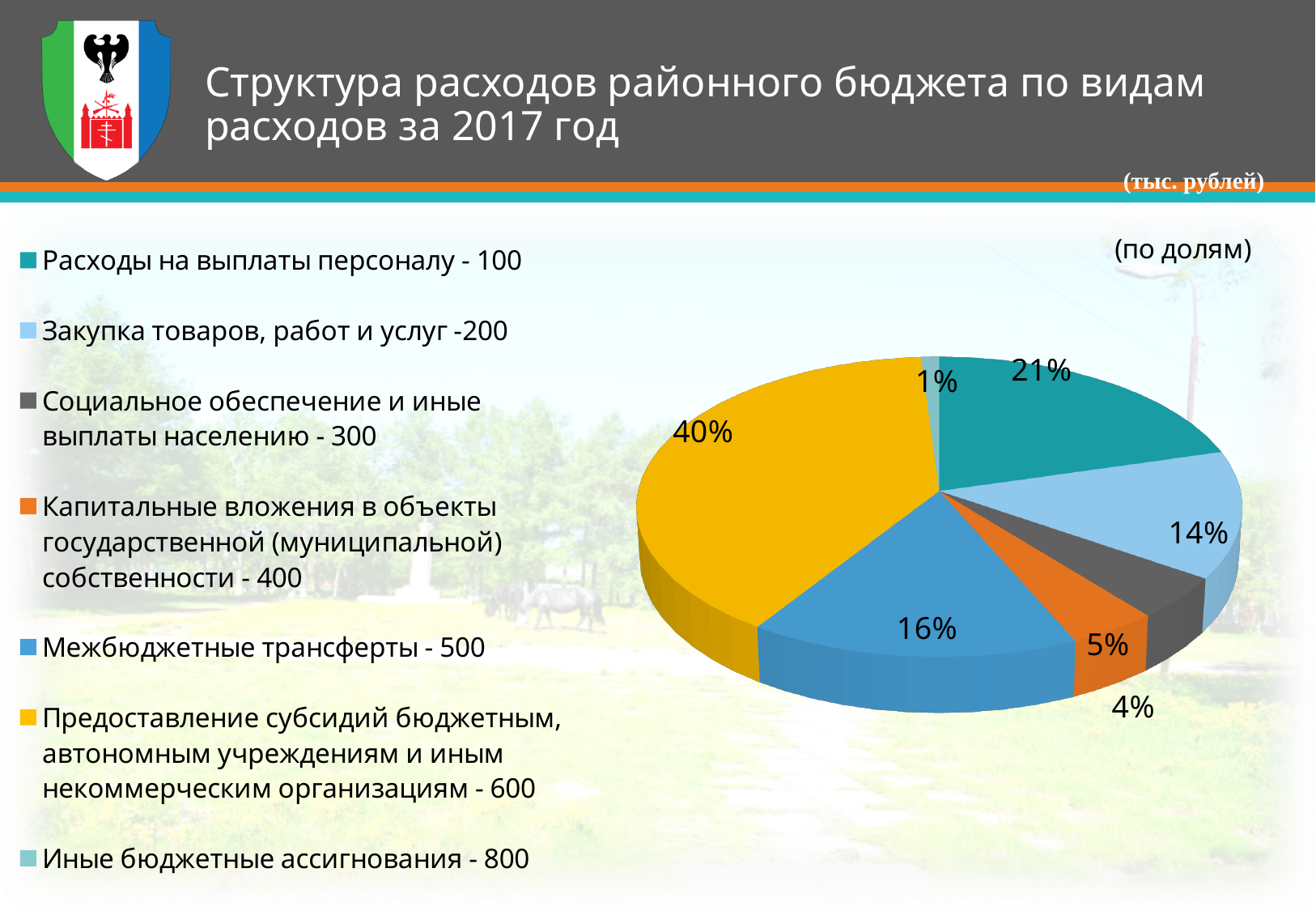
What share of the pie is labelled for "Иные бюджетные ассигнования - 800"? 1% Which category has the largest share of the pie? Предоставление субсидий бюджетным, автономным учреждениям и иным некоммерческим организациям - 600 What colour is the slice for "Межбюджетные трансферты - 500"? blue How many slices does the pie chart have? 7 What is the difference in percentage points between the share for "Предоставление субсидий бюджетным, автономным учреждениям и иным некоммерческим организациям - 600" and the share for "Расходы на выплаты персоналу - 100"? 19 What share of the pie is labelled for "Расходы на выплаты персоналу - 100"? 21% Which category has the smallest share of the pie? Иные бюджетные ассигнования - 800 What share of the pie is labelled for "Межбюджетные трансферты - 500"? 16% Which has the larger share: "Социальное обеспечение и иные выплаты населению - 300" or "Капитальные вложения в объекты государственной (муниципальной) собственности - 400"? Социальное обеспечение и иные выплаты населению - 300 What type of chart is shown on the slide? pie chart How many entries does the legend list? 7 What share of the pie is labelled for "Закупка товаров, работ и услуг -200"? 14%